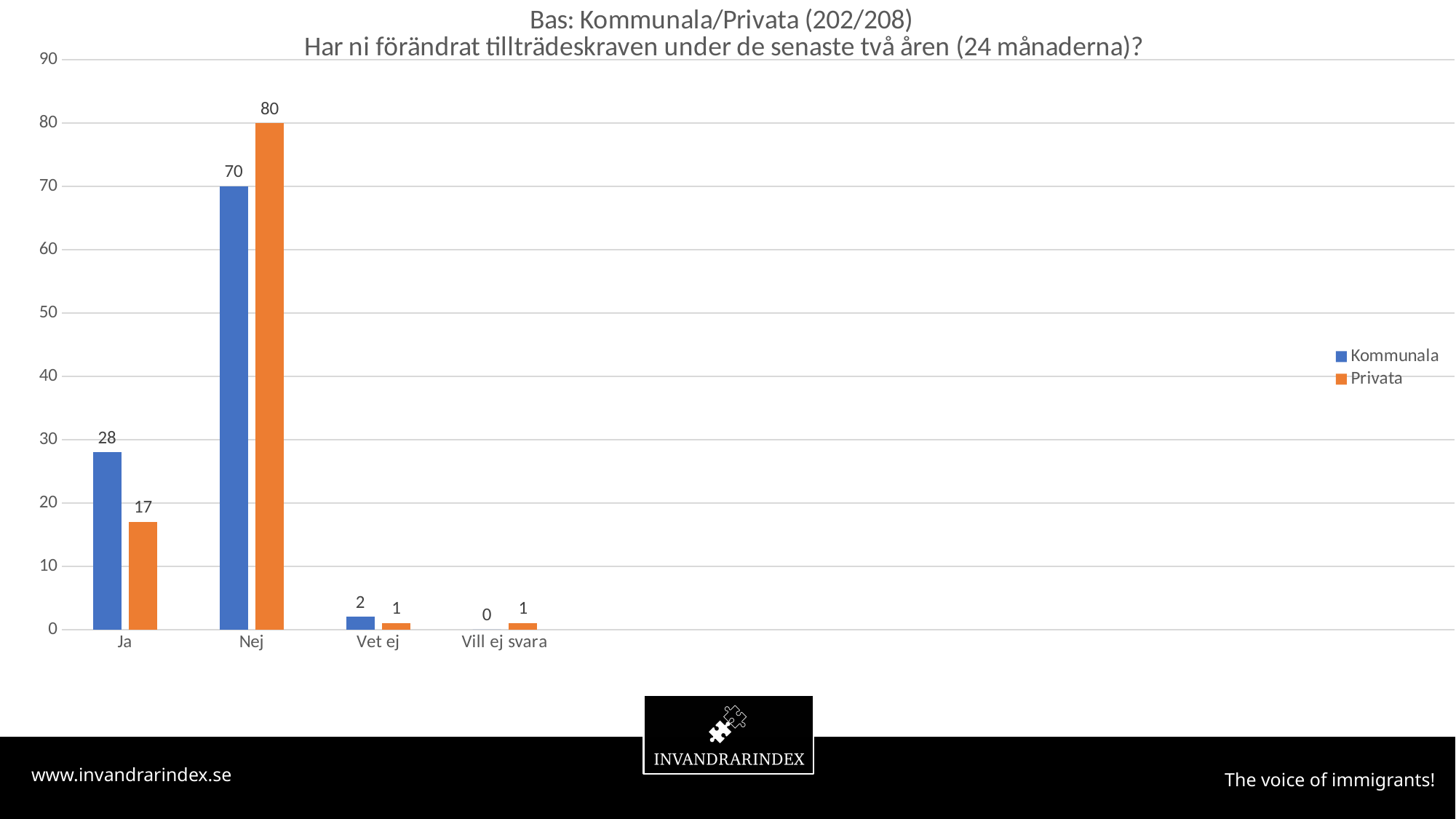
How many categories are shown on the x axis? 4 How many series does the legend list? 2 What is the difference between the Kommunala and Privata values in the Ja category? 11 What is the difference between the Privata and Kommunala values in the Nej category? 10 Which colour represents the Privata series? Orange What kind of chart is shown on the slide? Bar chart Which category has the lowest value for the Kommunala series? Vill ej svara What is the value for Kommunala in the Ja category? 28 What is the value for Privata in the Nej category? 80 In the Ja category, which series has the larger value, Kommunala or Privata? Kommunala What is the value for Kommunala in the Vill ej svara category? 0 Which category has the highest value for the Privata series? Nej